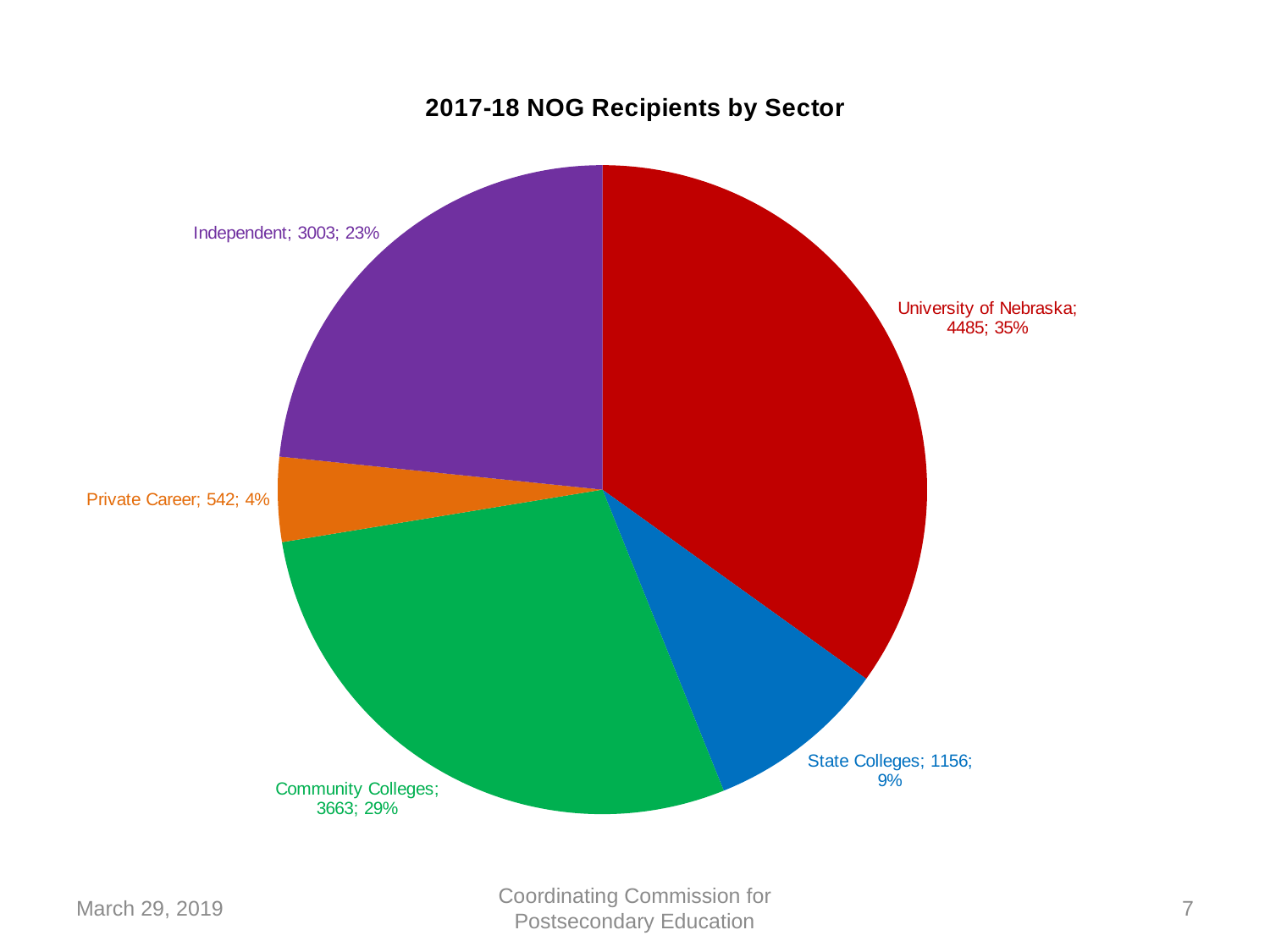
What is the title of the chart? 2017-18 NOG Recipients by Sector What type of chart is shown on the slide? pie chart How many sectors are shown in the pie chart? 5 Which sector has more NOG recipients, State Colleges or Independent? Independent What percentage share of NOG recipients does the Community Colleges sector have? 29% Which sector has the smallest number of NOG recipients? Private Career How many NOG recipients are in the Private Career sector? 542 What is the difference in NOG recipients between Community Colleges and Independent? 660 Which sector has the largest number of NOG recipients? University of Nebraska What colour is the slice for the Independent sector? purple What percentage share of NOG recipients does the State Colleges sector have? 9% How many NOG recipients are in the University of Nebraska sector? 4485